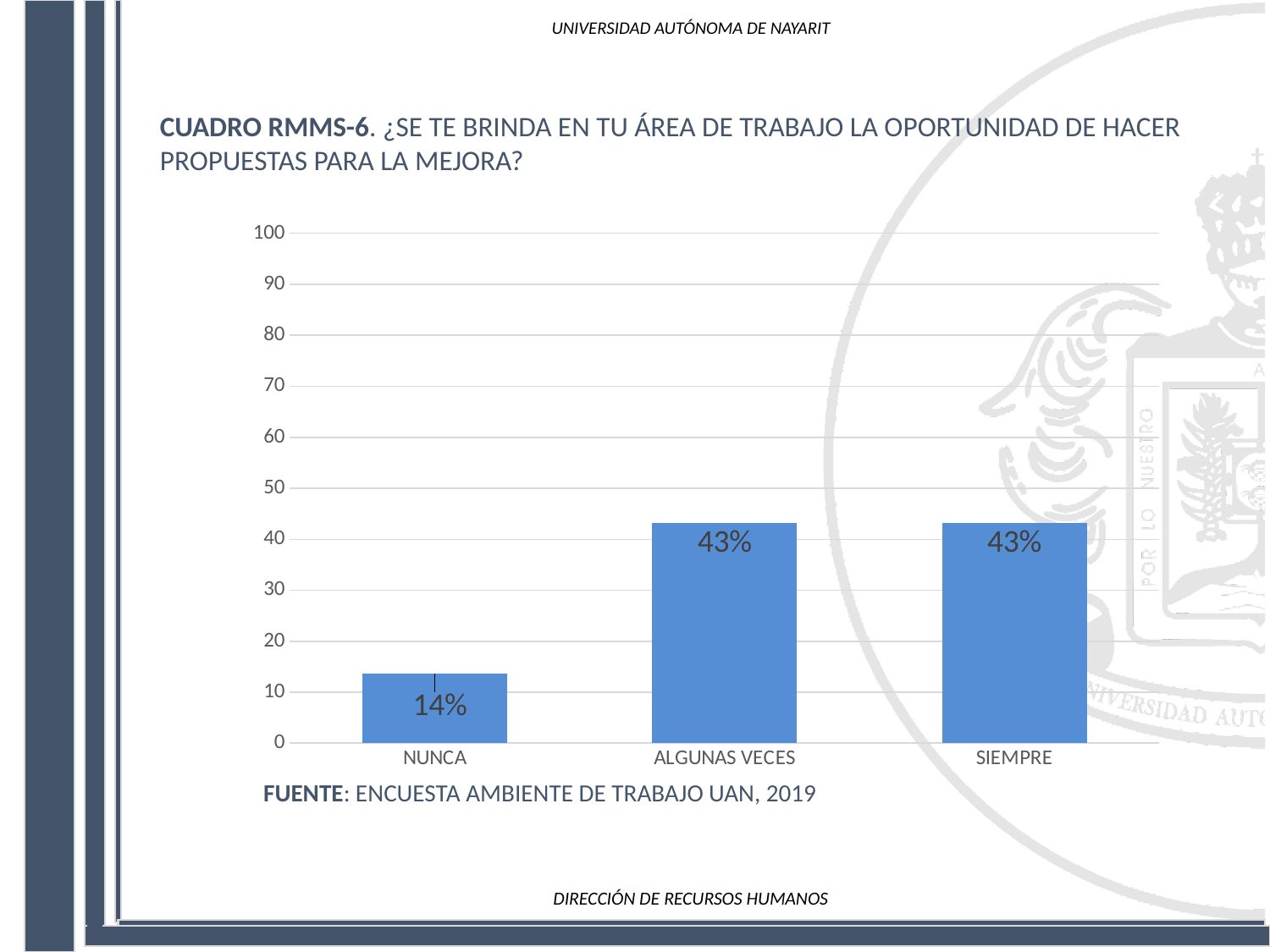
Which is larger, the value for NUNCA or the value for SIEMPRE? SIEMPRE Is the value for NUNCA greater or less than 10? greater What is the difference between the values for ALGUNAS VECES and NUNCA? 29% How many categories are shown on the x axis? 3 What is the highest value shown on the y axis? 100 What kind of chart is shown on the slide? bar chart What is the value for ALGUNAS VECES? 43% What is the source cited below the chart? ENCUESTA AMBIENTE DE TRABAJO UAN, 2019 Is the value for ALGUNAS VECES greater or less than 50? less What is the value for SIEMPRE? 43% What is the value for NUNCA? 14% Which category has the lowest value? NUNCA